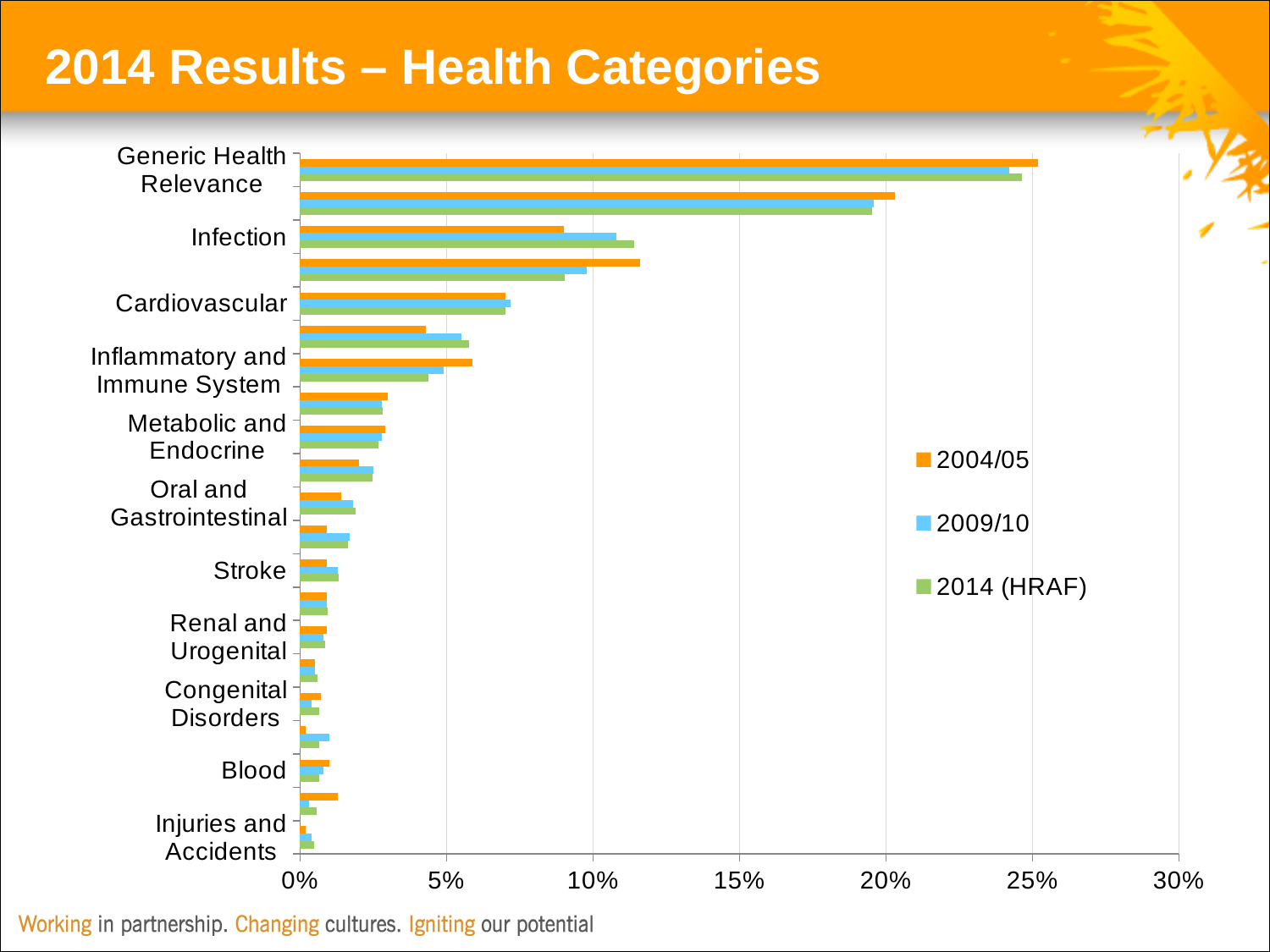
Which health category has the highest 2014 (HRAF) value? Generic Health Relevance For Inflammatory and Immune System, which is larger: the 2004/05 value or the 2014 (HRAF) value? 2004/05 How many series does the legend list? 3 Is the 2004/05 value for Metabolic and Endocrine greater or less than 5%? less Is the 2014 (HRAF) value for Infection greater or less than 10%? greater What is the title of the slide containing the chart? 2014 Results – Health Categories What are the three series named in the legend? 2004/05, 2009/10, 2014 (HRAF) Is the 2009/10 value for Cardiovascular greater or less than 10%? less What kind of chart is shown on the slide? Bar chart For Infection, which is larger: the 2004/05 value or the 2014 (HRAF) value? 2014 (HRAF)